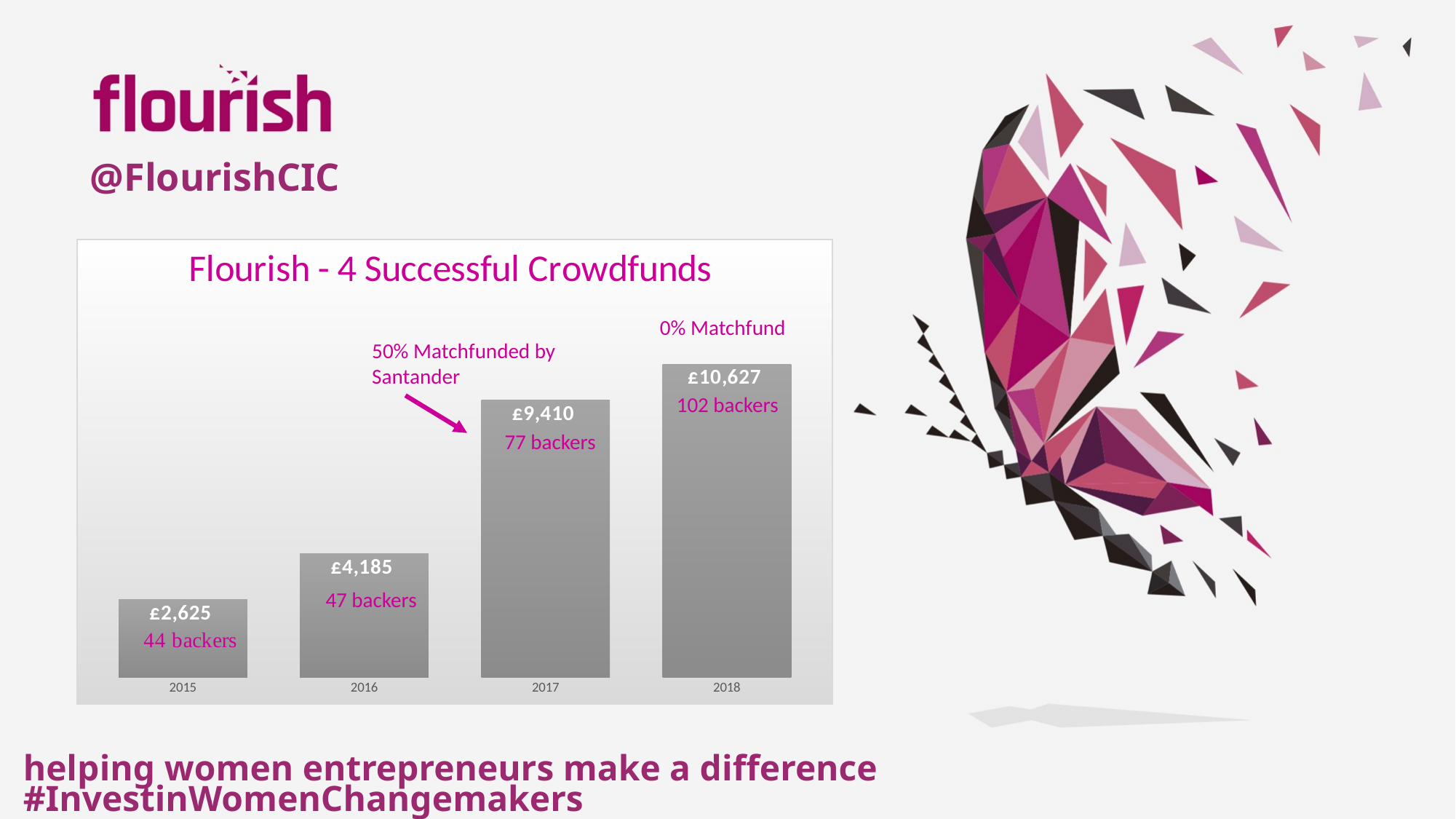
What amount was raised in the 2017 crowdfund? £9,410 How many backers did the 2018 crowdfund have? 102 backers Do the crowdfund amounts rise or fall from 2015 to 2018? Rise How many crowdfunds (bars) are shown in the chart? 4 Which year raised more, 2016 or 2017? 2017 What is the difference between the amounts raised in 2016 and 2015? £1,560 What amount was raised in the 2015 crowdfund? £2,625 Which year had the lowest crowdfund amount? 2015 What kind of chart is shown on the slide? Bar chart What is the title of the chart? Flourish - 4 Successful Crowdfunds Which year had the highest crowdfund amount? 2018 What is the difference between the amounts raised in 2018 and 2017? £1,217